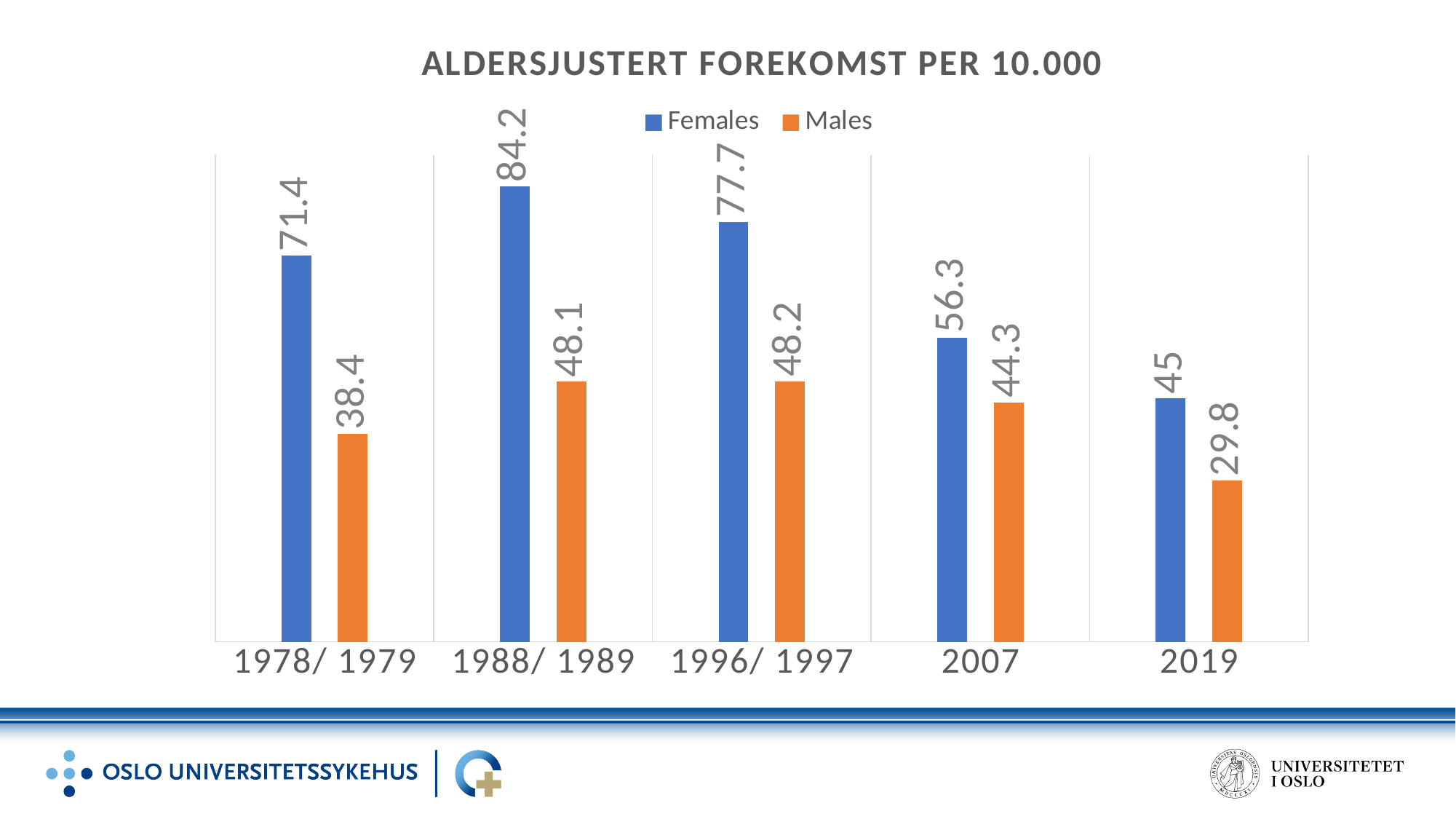
In which period is the Females value highest? 1988/ 1989 What is the value for Males in 2019? 29.8 What is the difference between the Females values in 1996/ 1997 and 2007? 21.4 What is the value for Females in 1988/ 1989? 84.2 What is the difference between the Females and Males values in 1978/ 1979? 33 What kind of chart is shown on the slide? Bar chart How many periods are shown on the x axis? 5 What is the value for Males in 2007? 44.3 Which is larger, the Males value in 1988/ 1989 or the Males value in 2007? 1988/ 1989 In which period is the Males value lowest? 2019 What is the title of the chart? ALDERSJUSTERT FOREKOMST PER 10.000 How many series does the legend list? 2